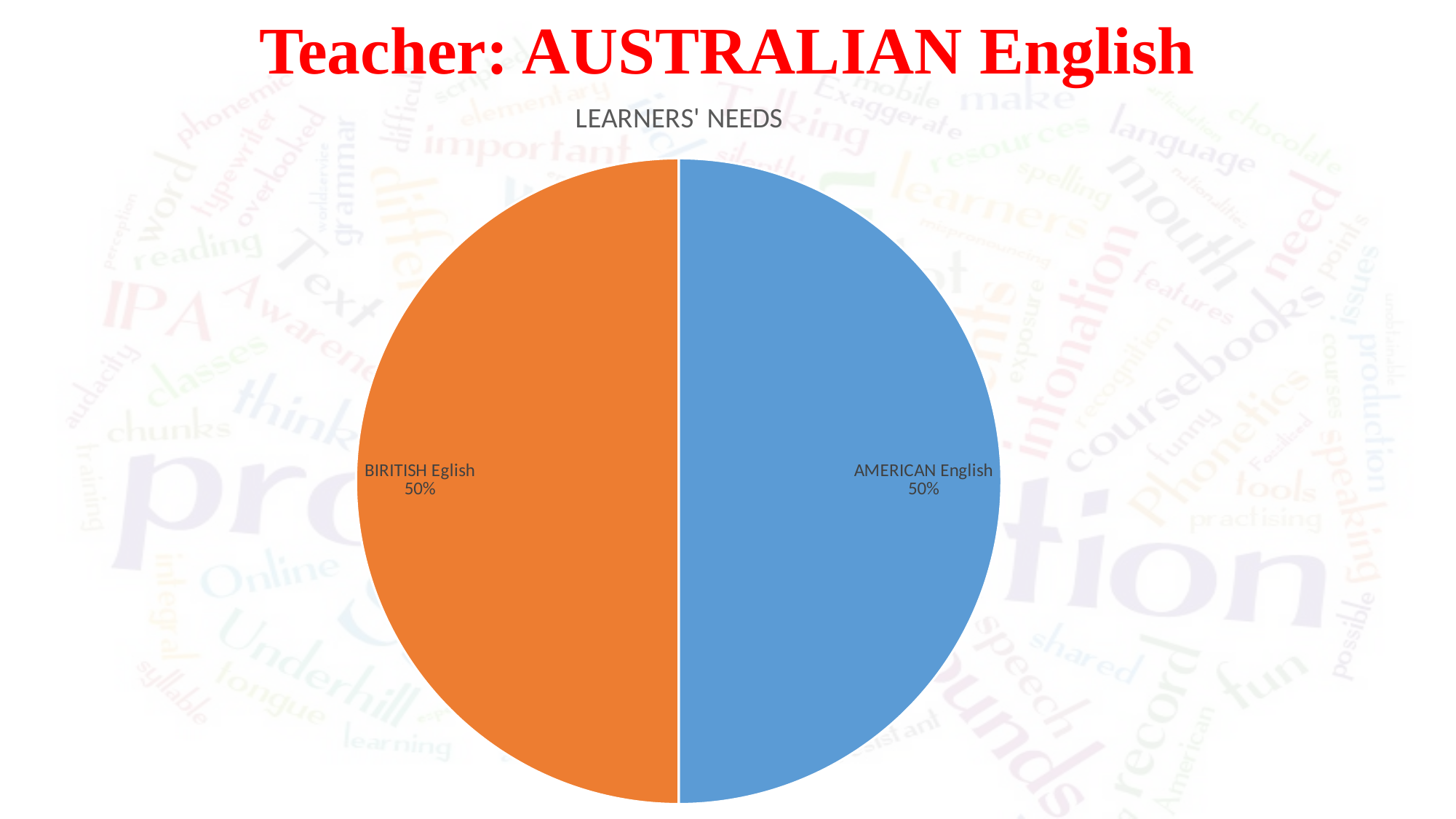
How many slices does the pie chart have? 2 What is the title of the chart? LEARNERS' NEEDS What share of the pie does BIRITISH Eglish have? 50% What is the total of the two slices shown in the pie chart? 100% What kind of chart is shown on the slide? Pie chart What share of the pie does AMERICAN English have? 50% Which colour is the AMERICAN English slice? Blue What is the difference between the shares for BIRITISH Eglish and AMERICAN English? 0% Is the share for BIRITISH Eglish greater or less than 25%? greater